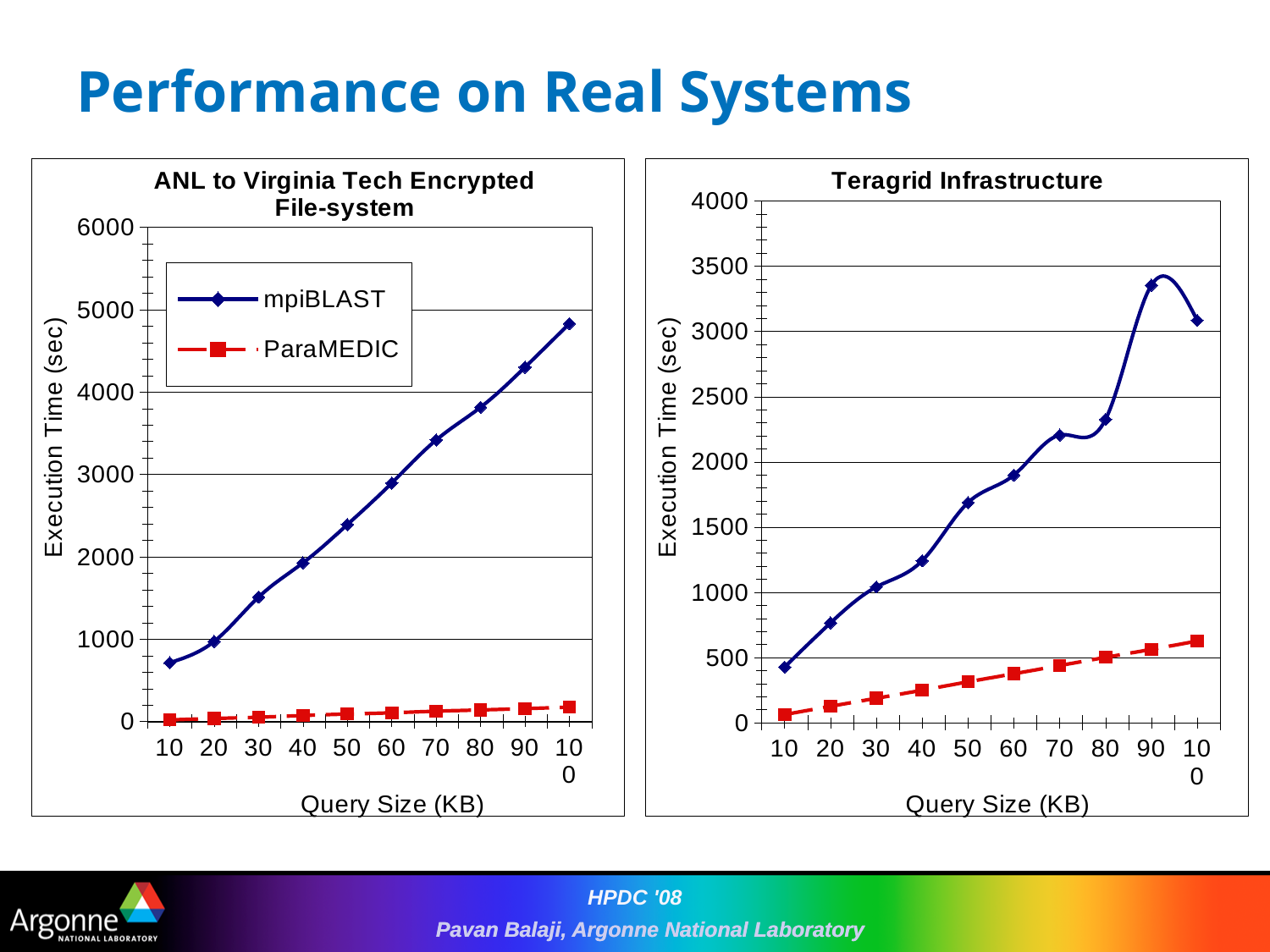
What type of chart is the 'ANL to Virginia Tech Encrypted File-system' chart? line chart In the 'ANL to Virginia Tech Encrypted File-system' chart, is the mpiBLAST execution time at query size 10 greater or less than 1000? less In the 'ANL to Virginia Tech Encrypted File-system' chart, which series has the larger execution time at query size 50, mpiBLAST or ParaMEDIC? mpiBLAST How many series does the legend of the 'ANL to Virginia Tech Encrypted File-system' chart list? 2 What is the y-axis label of the 'Teragrid Infrastructure' chart? Execution Time (sec) In the 'ANL to Virginia Tech Encrypted File-system' chart, how many query sizes are plotted along the x axis? 10 In the 'Teragrid Infrastructure' chart, is the execution time of the red square-marker line at query size 100 greater or less than 500? greater In the 'Teragrid Infrastructure' chart, is the execution time of the blue diamond-marker line at query size 10 greater or less than 500? less In the 'ANL to Virginia Tech Encrypted File-system' chart, does the mpiBLAST execution time rise or fall as query size increases? rise In the 'Teragrid Infrastructure' chart, at which query size does the blue diamond-marker line reach its highest execution time? 90 In the 'ANL to Virginia Tech Encrypted File-system' chart, at which query size is the mpiBLAST execution time highest? 100